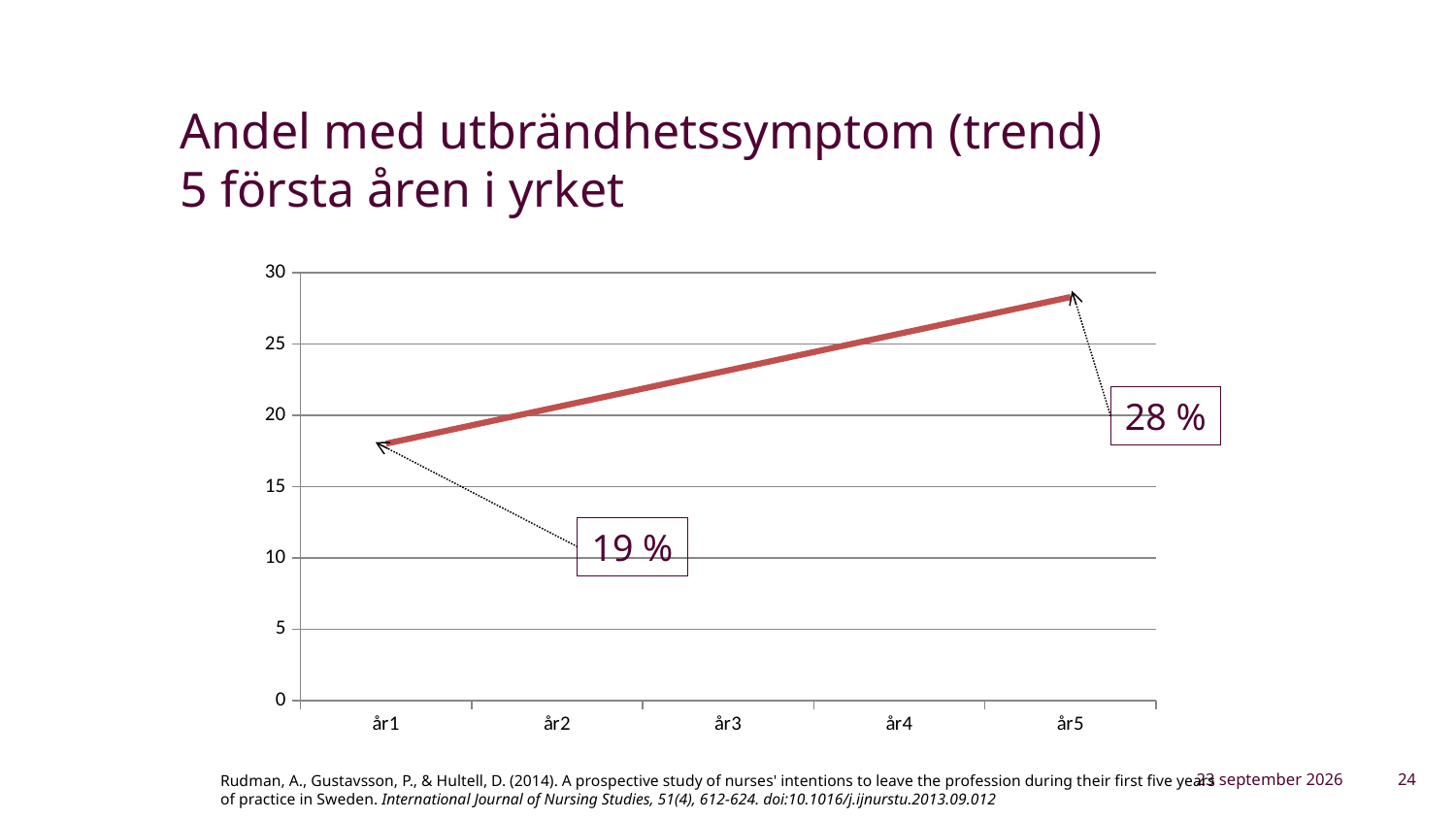
Is the value for år3 greater or less than 20? greater Which year has the lowest value on the chart? år1 Which is larger, the value for år1 or the value for år5? år5 How many years are shown on the x axis? 5 Which year has the highest value on the chart? år5 What value is labelled for år5 on the chart? 28 % What is the difference between the labelled values for år5 and år1? 9 % What is the title of the slide? Andel med utbrändhetssymptom (trend) 5 första åren i yrket What kind of chart is shown on the slide? line chart Does the line rise or fall from år1 to år5? rises Is the value for år4 greater or less than 25? greater What value is labelled for år1 on the chart? 19 %